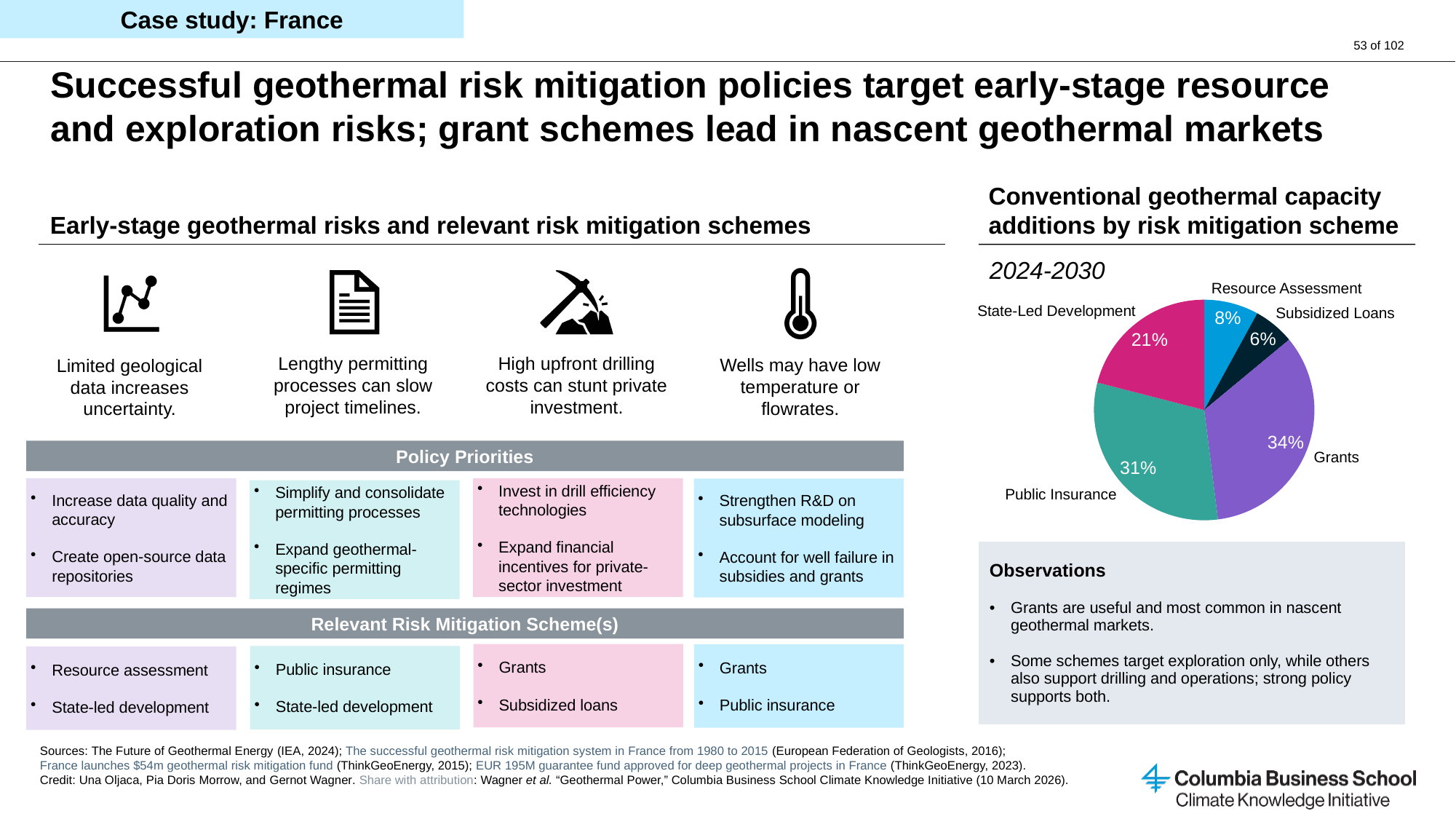
How many slices does the pie chart have? 5 What share of the pie chart is Subsidized Loans? 6% Which risk mitigation scheme has the largest share of the pie chart? Grants What time period does the pie chart cover? 2024-2030 What is the difference in percentage points between the Grants and Public Insurance slices? 3 What share of the pie chart is State-Led Development? 21% What type of chart shows conventional geothermal capacity additions by risk mitigation scheme? Pie chart Which risk mitigation scheme has the smallest share of the pie chart? Subsidized Loans What share of the pie chart is Public Insurance? 31% Which slice is larger, State-Led Development or Resource Assessment? State-Led Development What share of the pie chart is Resource Assessment? 8% What share of conventional geothermal capacity additions by risk mitigation scheme is attributed to Grants? 34%